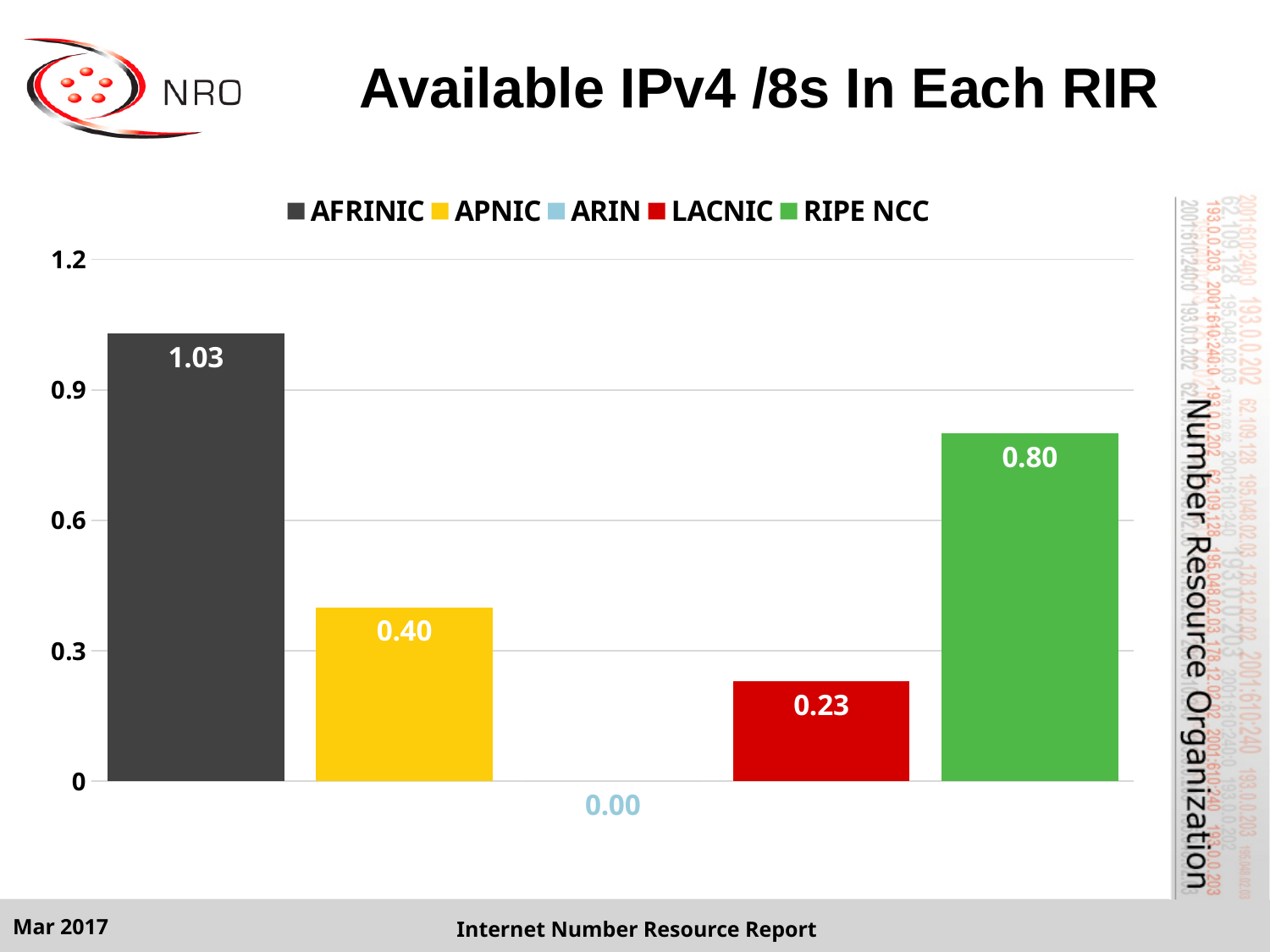
Which RIR has the highest number of available IPv4 /8s? AFRINIC What is the difference between the values for AFRINIC and RIPE NCC? 0.23 What kind of chart is shown on the slide? Bar chart What is the value for ARIN? 0.00 What is the value for RIPE NCC? 0.80 Which RIR has the lowest number of available IPv4 /8s? ARIN What is the value for LACNIC? 0.23 How many RIRs are shown in the chart? 5 What is the title of the chart? Available IPv4 /8s In Each RIR What is the value for AFRINIC? 1.03 What is the difference between the values for APNIC and LACNIC? 0.17 Which is larger, the value for APNIC or the value for LACNIC? APNIC